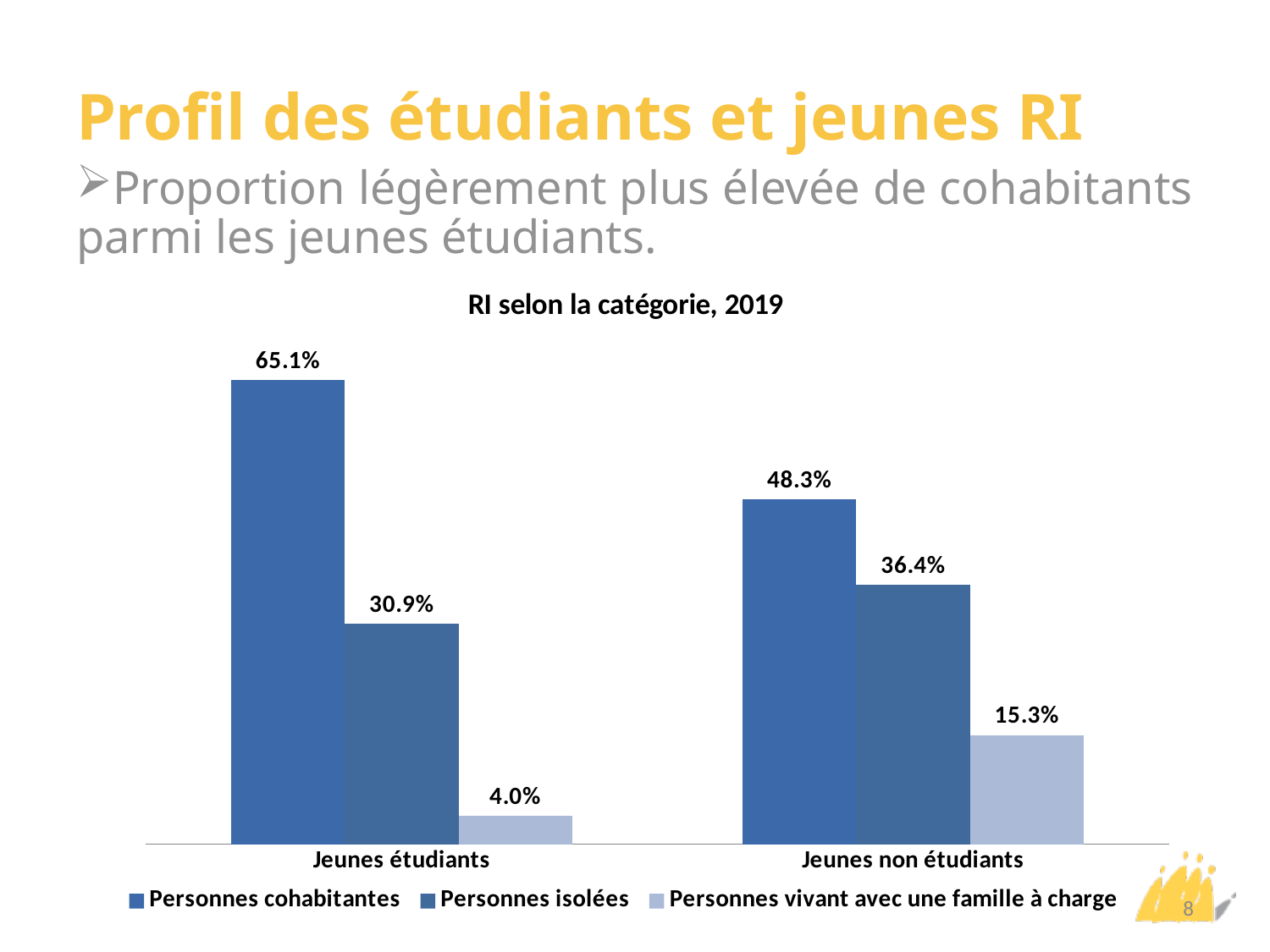
Which is larger: Personnes isolées for Jeunes étudiants or for Jeunes non étudiants? Jeunes non étudiants What is the value for Personnes isolées among Jeunes étudiants? 30.9% What is the value for Personnes vivant avec une famille à charge among Jeunes non étudiants? 15.3% How many categories are shown on the x axis? 2 What is the difference between Personnes cohabitantes for Jeunes étudiants and for Jeunes non étudiants? 16.8% What is the difference between Personnes vivant avec une famille à charge for Jeunes non étudiants and for Jeunes étudiants? 11.3% What is the value for Personnes cohabitantes among Jeunes étudiants? 65.1% Which series has the lowest value for Jeunes étudiants? Personnes vivant avec une famille à charge What is the title of the chart? RI selon la catégorie, 2019 Which series has the highest value for Jeunes non étudiants? Personnes cohabitantes What kind of chart is shown on the slide? Bar chart How many series does the legend list? 3